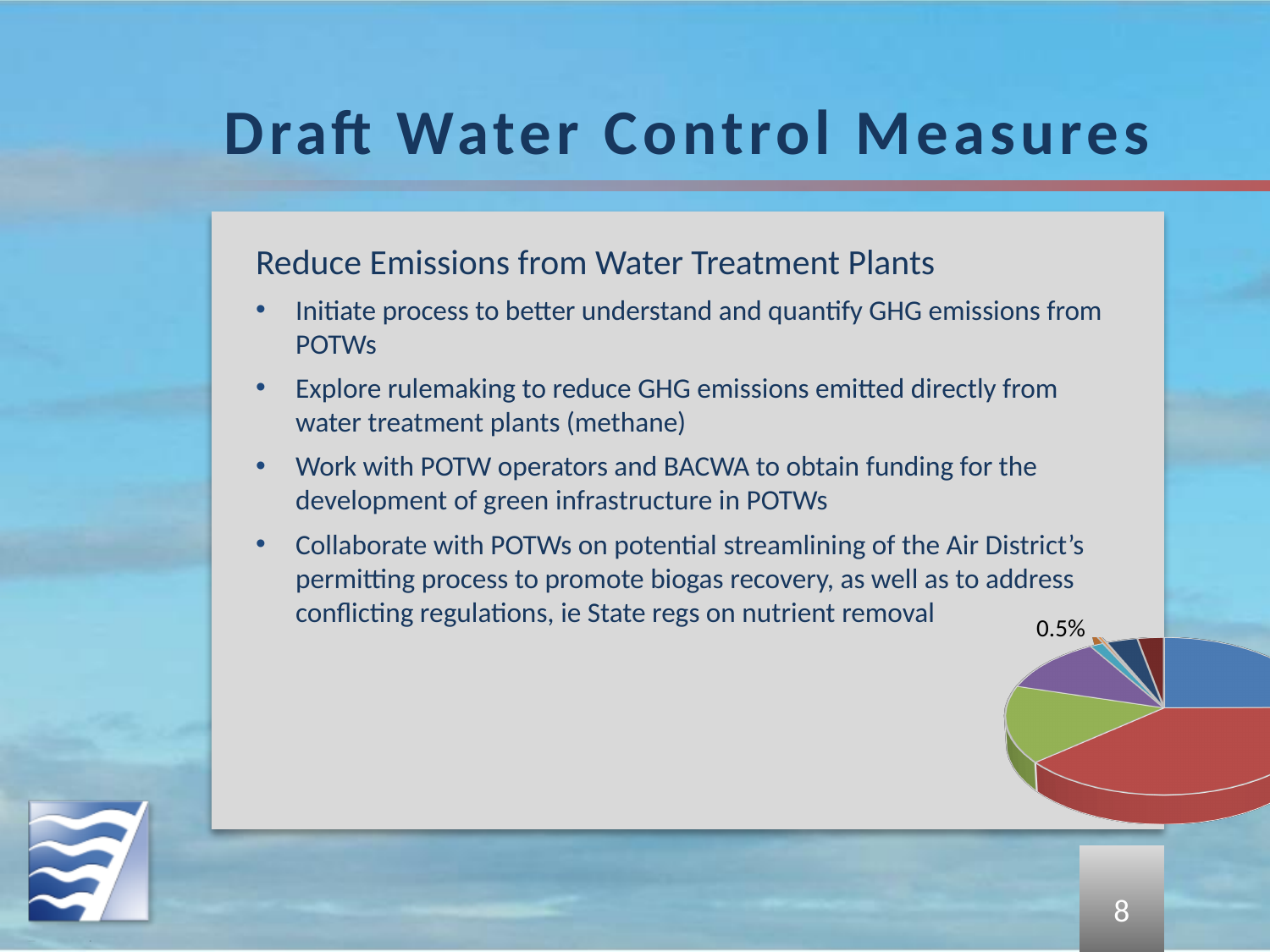
Which colour slice of the pie chart is the largest? red What kind of chart is shown in the bottom-right corner of the slide? pie chart Does the pie chart have a title or legend shown on the slide? No What is the only data label printed on the pie chart? 0.5%